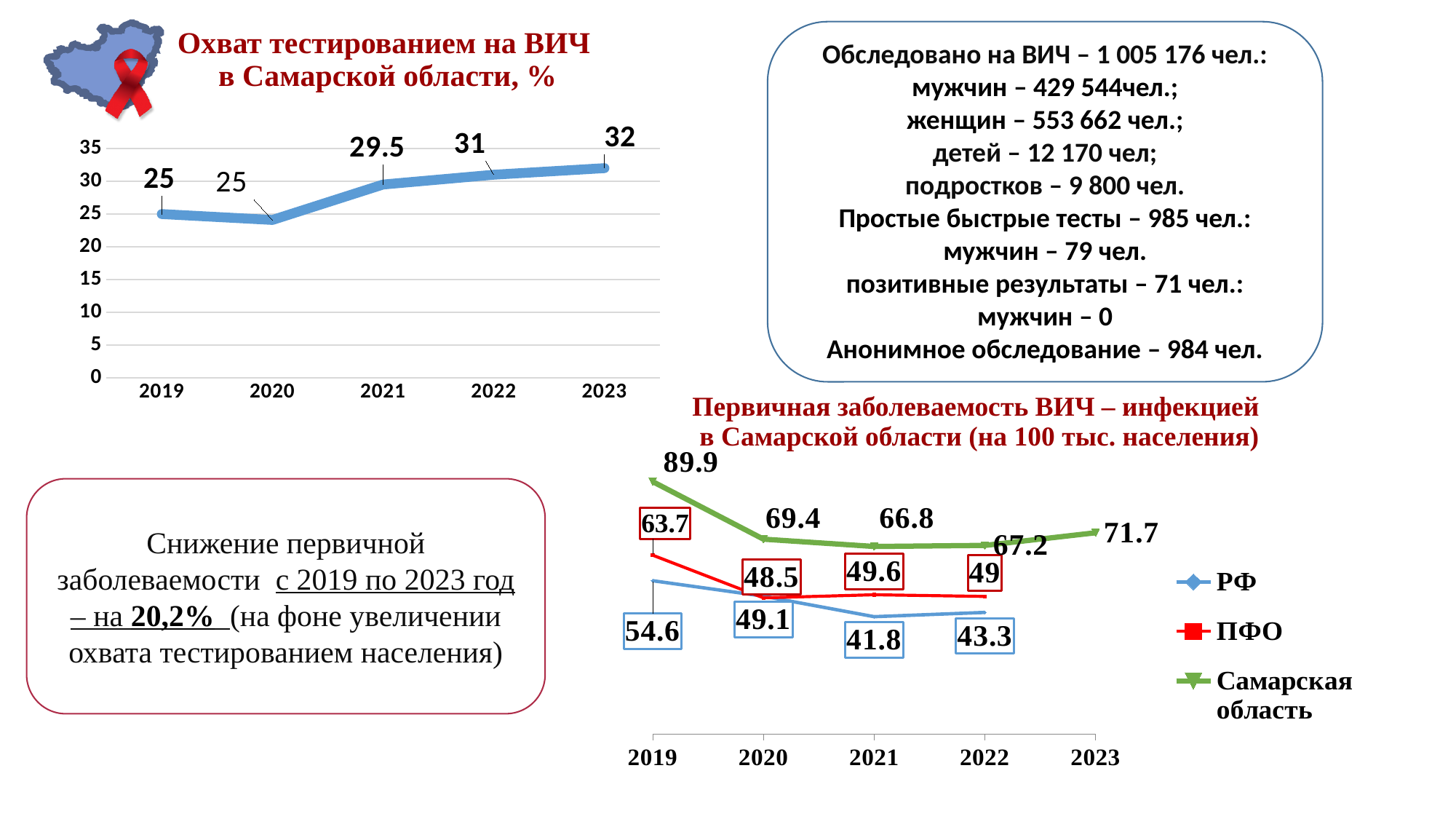
In the chart 'Первичная заболеваемость ВИЧ – инфекцией в Самарской области', what is the value for РФ in 2021? 41.8 In the chart 'Охват тестированием на ВИЧ в Самарской области, %', which year has the highest value? 2023 In the chart 'Охват тестированием на ВИЧ в Самарской области, %', what is the value for 2023? 32 In the chart 'Первичная заболеваемость ВИЧ – инфекцией в Самарской области', how many series does the legend list? 3 In the chart 'Охват тестированием на ВИЧ в Самарской области, %', what is the value for 2021? 29.5 In the chart 'Первичная заболеваемость ВИЧ – инфекцией в Самарской области', what is the difference between the Самарская область values for 2019 and 2020? 20.5 In the chart 'Охват тестированием на ВИЧ в Самарской области, %', how many years are plotted on the x axis? 5 In the chart 'Первичная заболеваемость ВИЧ – инфекцией в Самарской области', what is the value for Самарская область in 2019? 89.9 In the chart 'Охват тестированием на ВИЧ в Самарской области, %', what is the difference between the 2023 and 2019 values? 7 In the chart 'Первичная заболеваемость ВИЧ – инфекцией в Самарской области', which is larger in 2022: the value for ПФО or the value for РФ? ПФО In the chart 'Первичная заболеваемость ВИЧ – инфекцией в Самарской области', what is the value for ПФО in 2020? 48.5 What type of chart is 'Охват тестированием на ВИЧ в Самарской области, %'? Line chart